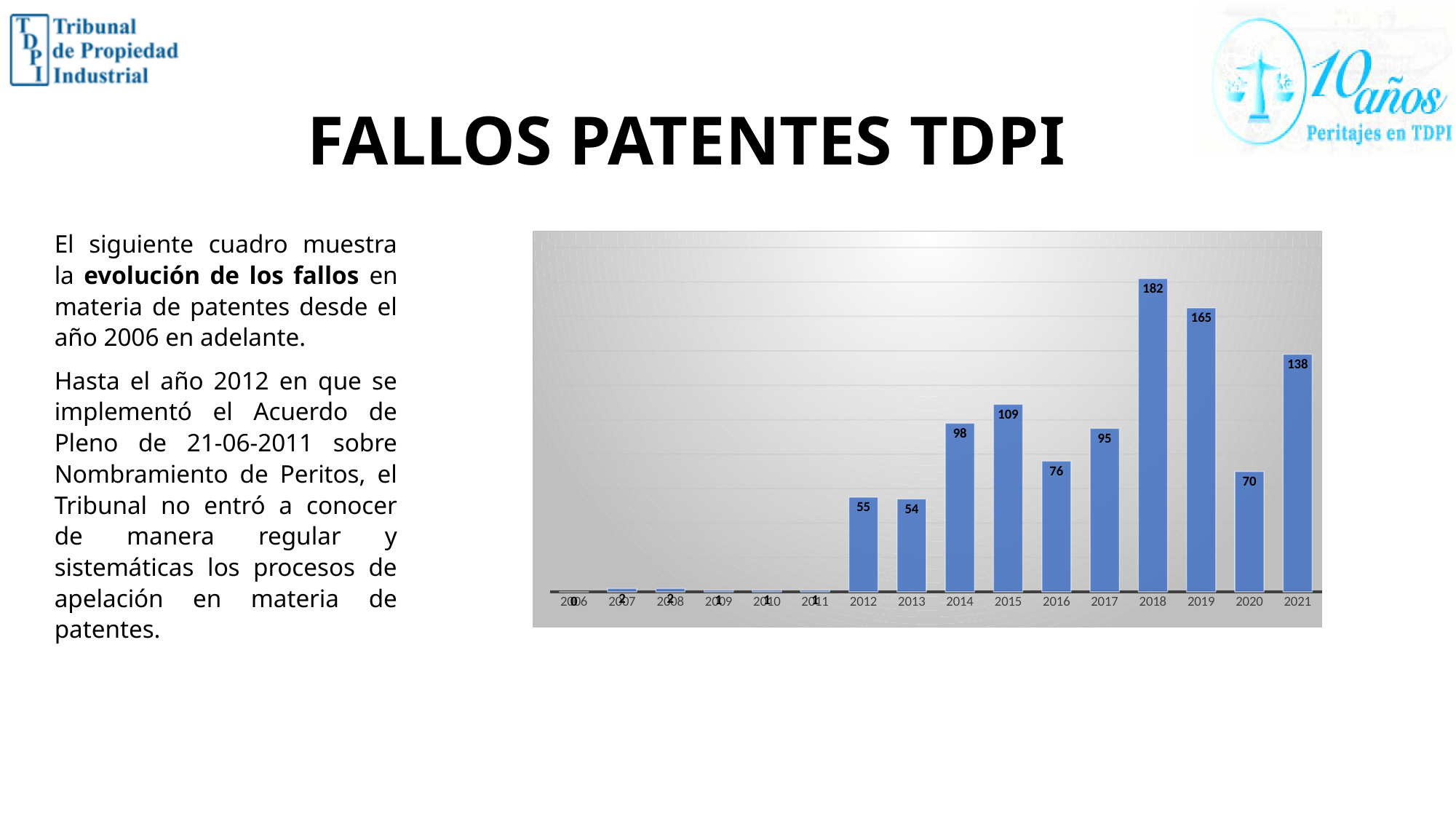
What is the difference between the values for 2018 and 2019? 17 What kind of chart is shown on the slide? Bar chart Do the values rise or fall from 2019 to 2020? Fall What is the difference between the values for 2021 and 2020? 68 How many years are shown on the x axis? 16 Which year from 2012 onward has the lowest value? 2013 What is the value for 2018? 182 What is the value for 2012? 55 What is the value for 2021? 138 Which is larger, the value for 2015 or the value for 2017? 2015 What is the value for 2016? 76 Which year has the highest value? 2018